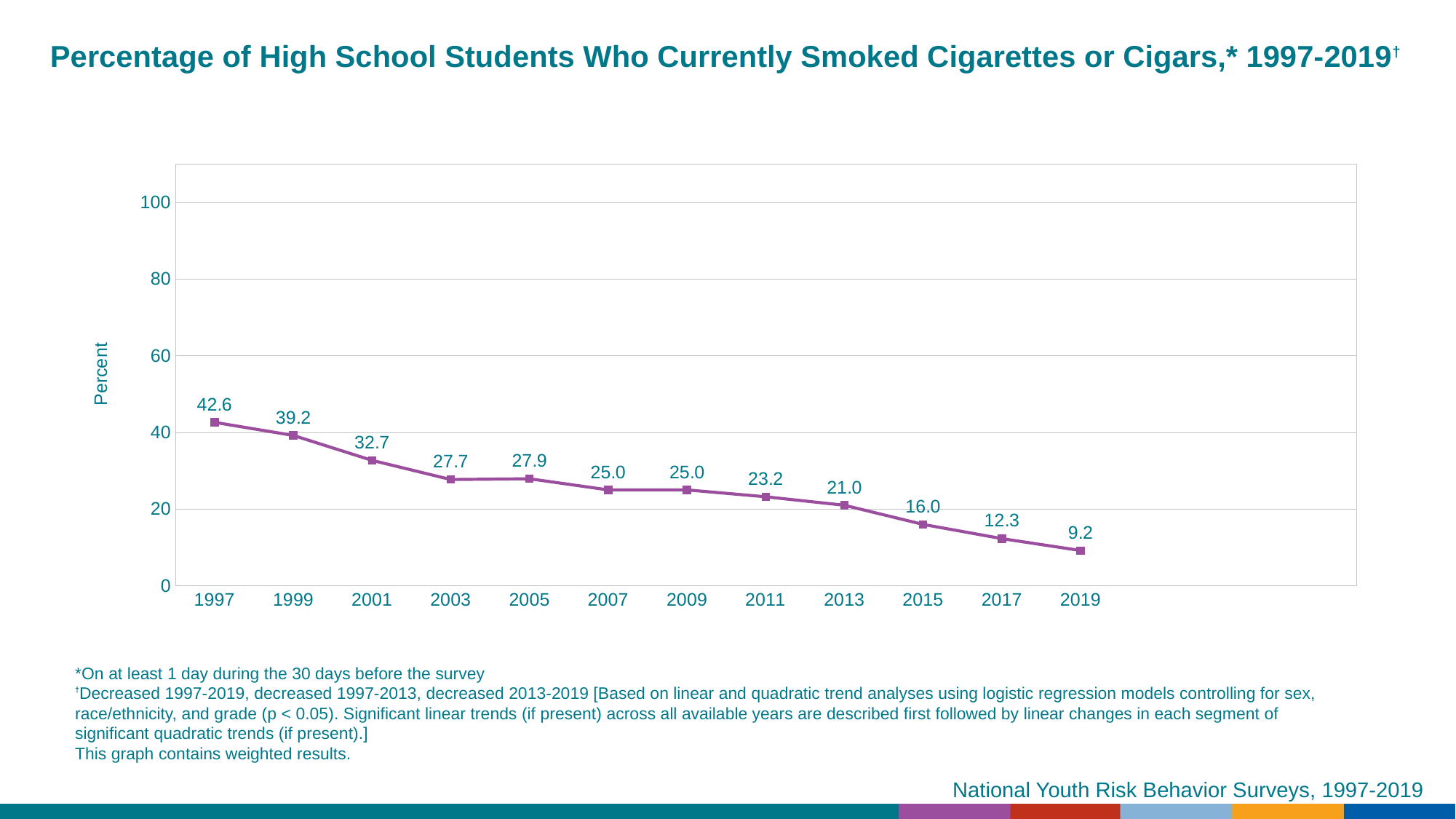
What is the value plotted for 2011? 23.2 What is the difference between the 1997 value and the 2019 value? 33.4 What is the difference between the 2013 value and the 2015 value? 5.0 Which year has the lowest percentage? 2019 Which year has a larger value, 2001 or 2007? 2001 What kind of chart is shown on the slide? Line chart What percentage of high school students currently smoked cigarettes or cigars in 1997? 42.6 What is the value plotted for 2019? 9.2 Which year has the highest percentage? 1997 Is the value for 2015 greater or less than 20? less Do the values generally rise or fall from 1997 to 2019? Fall How many years are plotted on the chart? 12